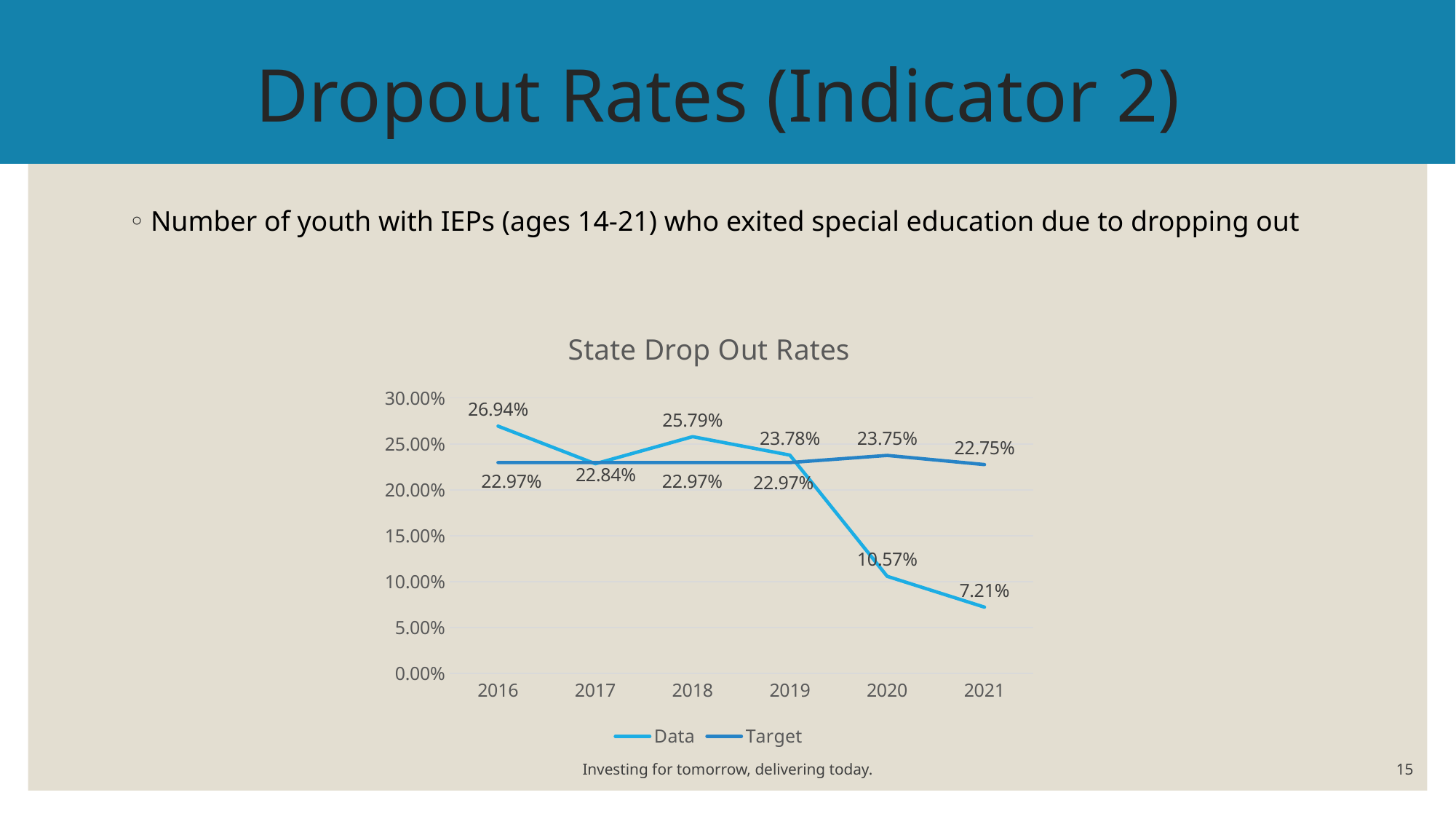
In 2020, which series has the larger value in the State Drop Out Rates chart, Data or Target? Target In which year is the Data series lowest in the State Drop Out Rates chart? 2021 What is the Data value for 2016 in the State Drop Out Rates chart? 26.94% Does the Data series rise or fall overall from 2016 to 2021 in the State Drop Out Rates chart? fall By how much did the Data value fall from 2016 to 2021 in the State Drop Out Rates chart? 19.73% What is the Data value for 2021 in the State Drop Out Rates chart? 7.21% How many years are plotted along the x axis of the State Drop Out Rates chart? 6 What is the Target value for 2020 in the State Drop Out Rates chart? 23.75% What is the Data value for 2020 in the State Drop Out Rates chart? 10.57% How many series does the legend of the State Drop Out Rates chart list? 2 In which year is the Data series highest in the State Drop Out Rates chart? 2016 What kind of chart is shown on the slide? line chart